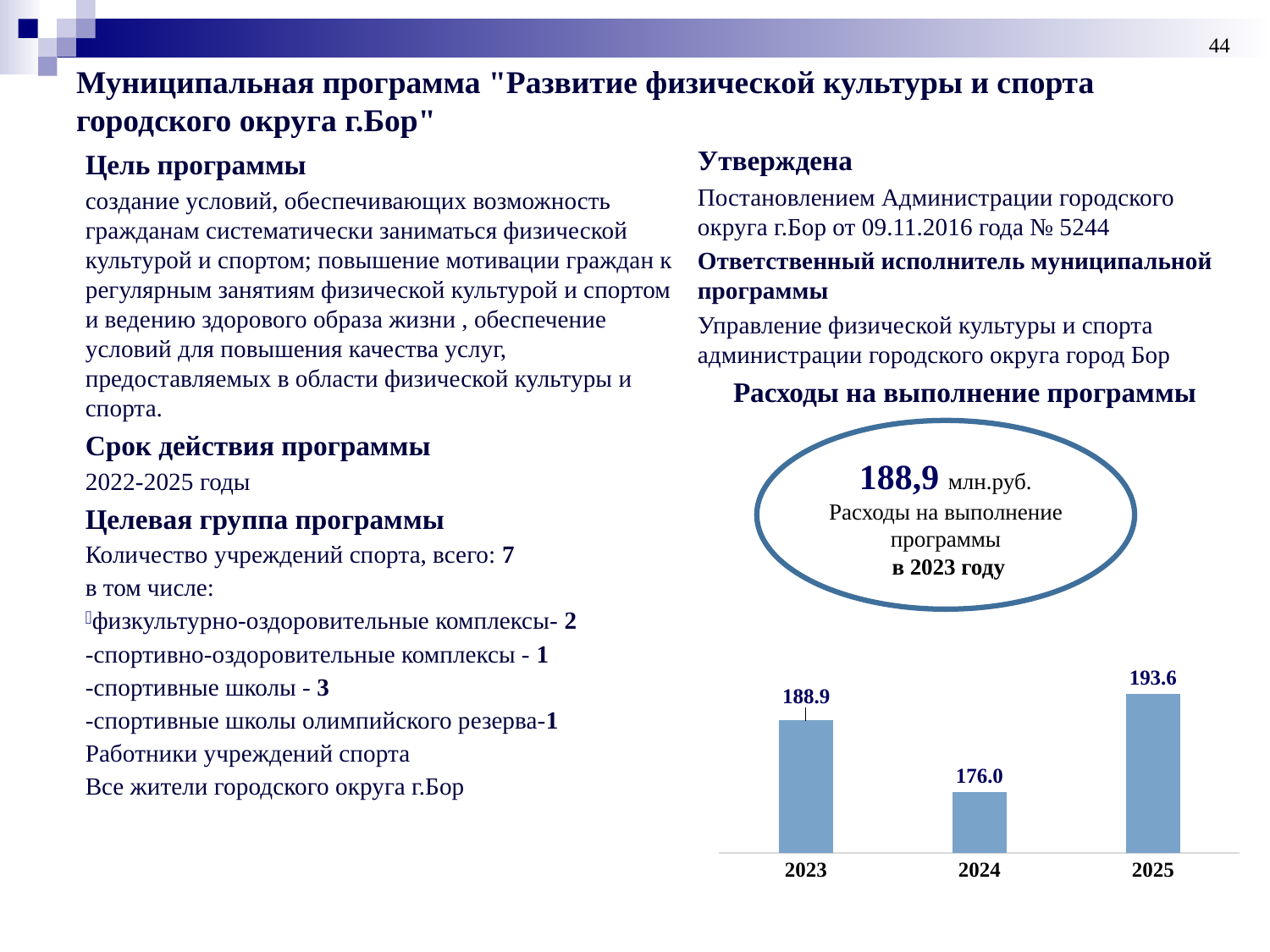
What type of chart is shown on the slide? bar chart Which year has the lowest value in the chart? 2024 What is the value shown for 2023 in the chart? 188.9 Which is larger, the value for 2023 or the value for 2024? 2023 How many years are shown in the chart? 3 What is the title of the chart on the slide? Расходы на выполнение программы What is the value shown for 2025 in the chart? 193.6 What is the difference between the values for 2025 and 2023? 4.7 What is the value shown for 2024 in the chart? 176.0 What is the difference between the values for 2025 and 2024? 17.6 Which year has the highest value in the chart? 2025 What is the difference between the values for 2023 and 2024? 12.9